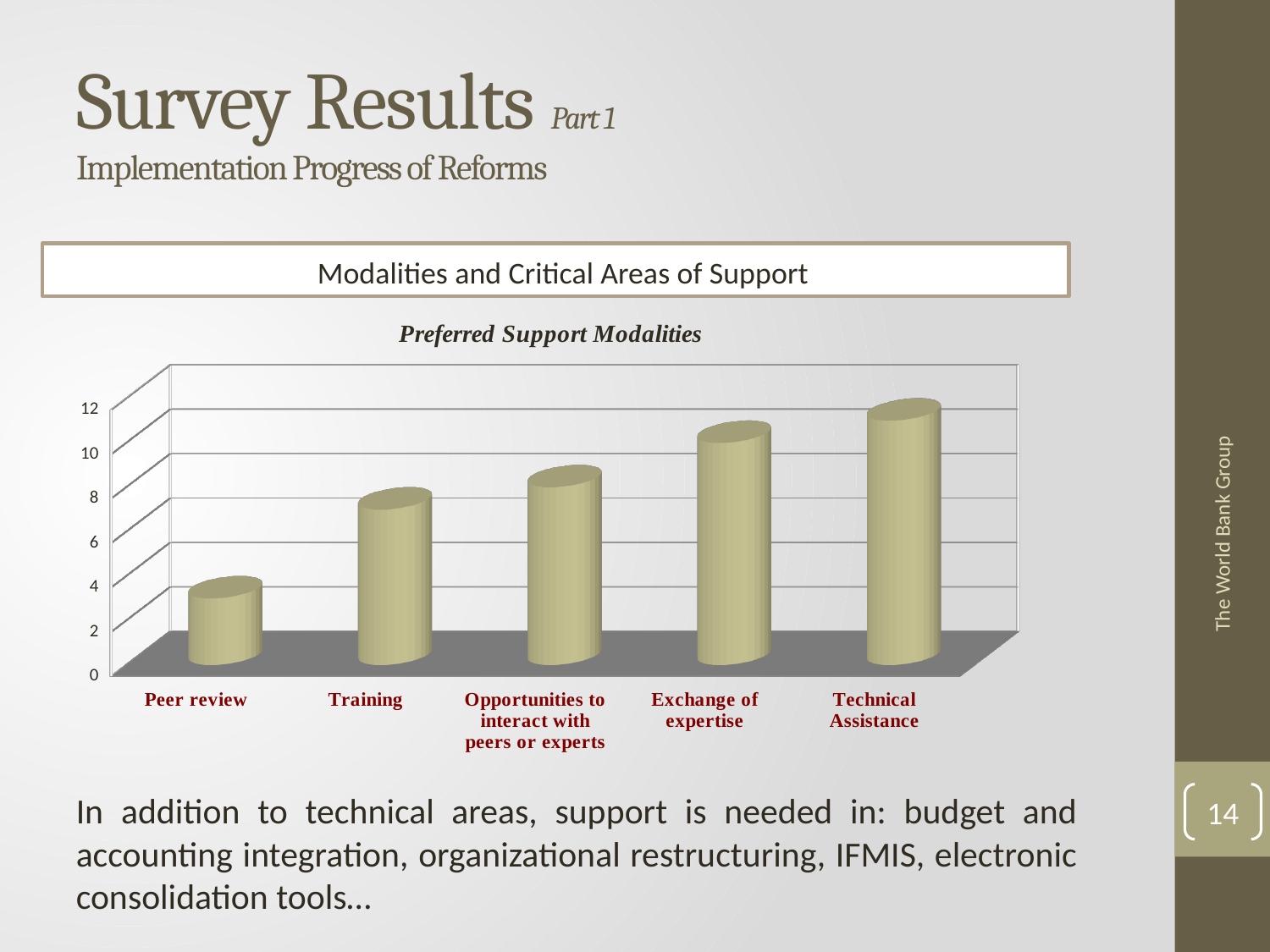
Which has a larger value, Exchange of expertise or Opportunities to interact with peers or experts? Exchange of expertise Is the value for Training greater or less than 6? greater Which has a larger value, Training or Peer review? Training Do the values rise or fall moving from left to right along the x axis? rise What is the title of the chart? Preferred Support Modalities Which support modality has the lowest value in the chart? Peer review Is the value for Exchange of expertise greater or less than 8? greater Is the value for Technical Assistance greater or less than 10? greater What kind of chart is shown on the slide? bar chart Which support modality has the highest value in the chart? Technical Assistance How many support modalities are shown on the x axis of the chart? 5